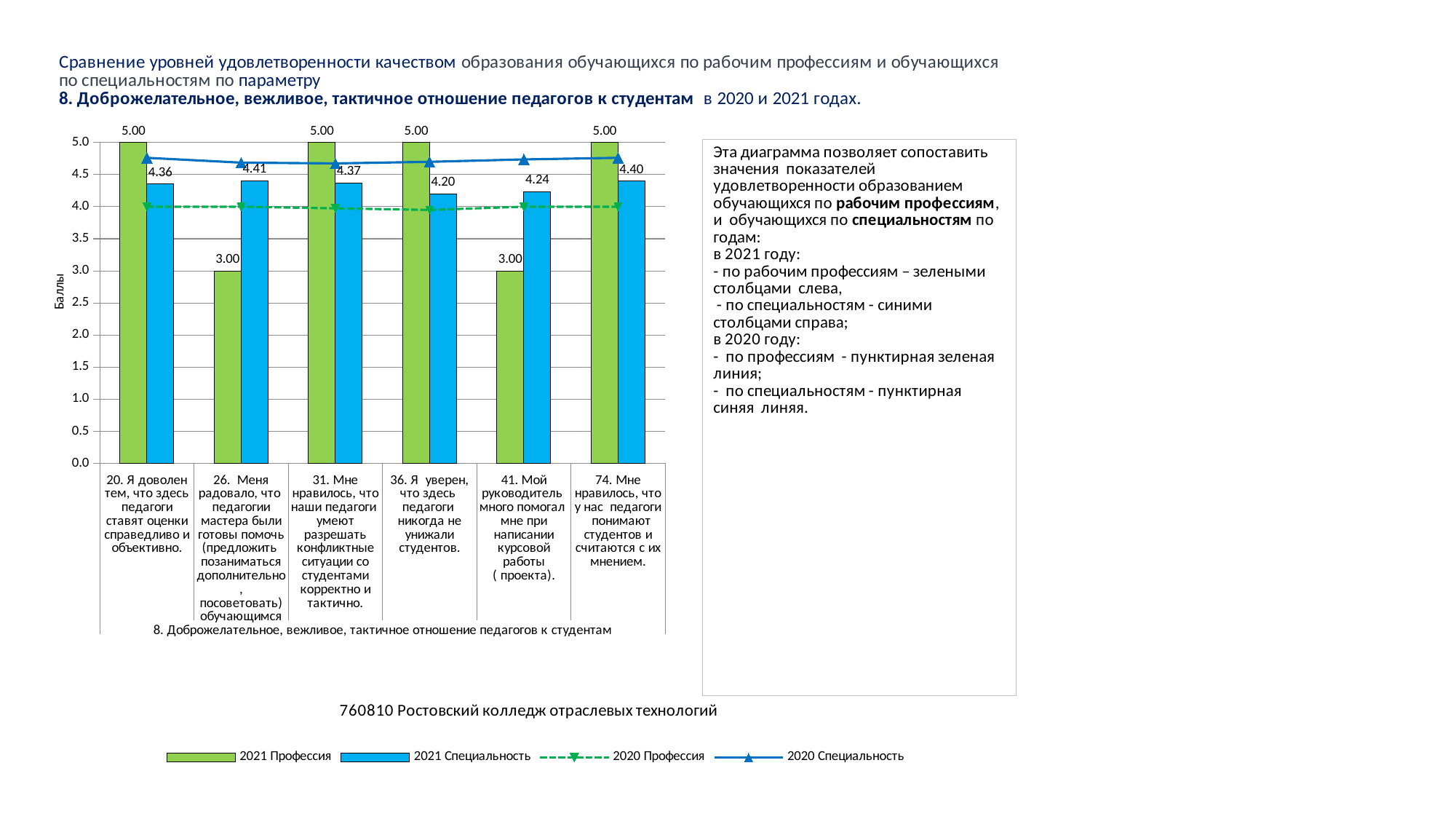
Is the 2020 Специальность value for question 20 greater or less than 4.5? greater For question 20, what is the difference between the 2021 Профессия value and the 2021 Специальность value? 0.64 What is the title of the vertical axis of the chart? Баллы What is the value of the 2021 Профессия bar for question 41 (Мой руководитель много помогал мне при написании курсовой работы)? 3.00 What is the difference between the 2021 Специальность value and the 2021 Профессия value for question 26? 1.41 For question 41, which is larger: the 2021 Профессия value or the 2021 Специальность value? 2021 Специальность What is the value of the 2021 Специальность bar for question 36 (Я уверен, что здесь педагоги никогда не унижали студентов)? 4.20 Which category has the lowest 2021 Специальность value? 36. Я уверен, что здесь педагоги никогда не унижали студентов. How many categories (questions) are shown on the x axis of the chart? 6 How many series does the chart legend list? 4 What is the value of the 2021 Профессия bar for question 20 (Я доволен тем, что здесь педагоги ставят оценки справедливо и объективно)? 5.00 Is the 2020 Профессия value for question 36 greater or less than 4.5? less